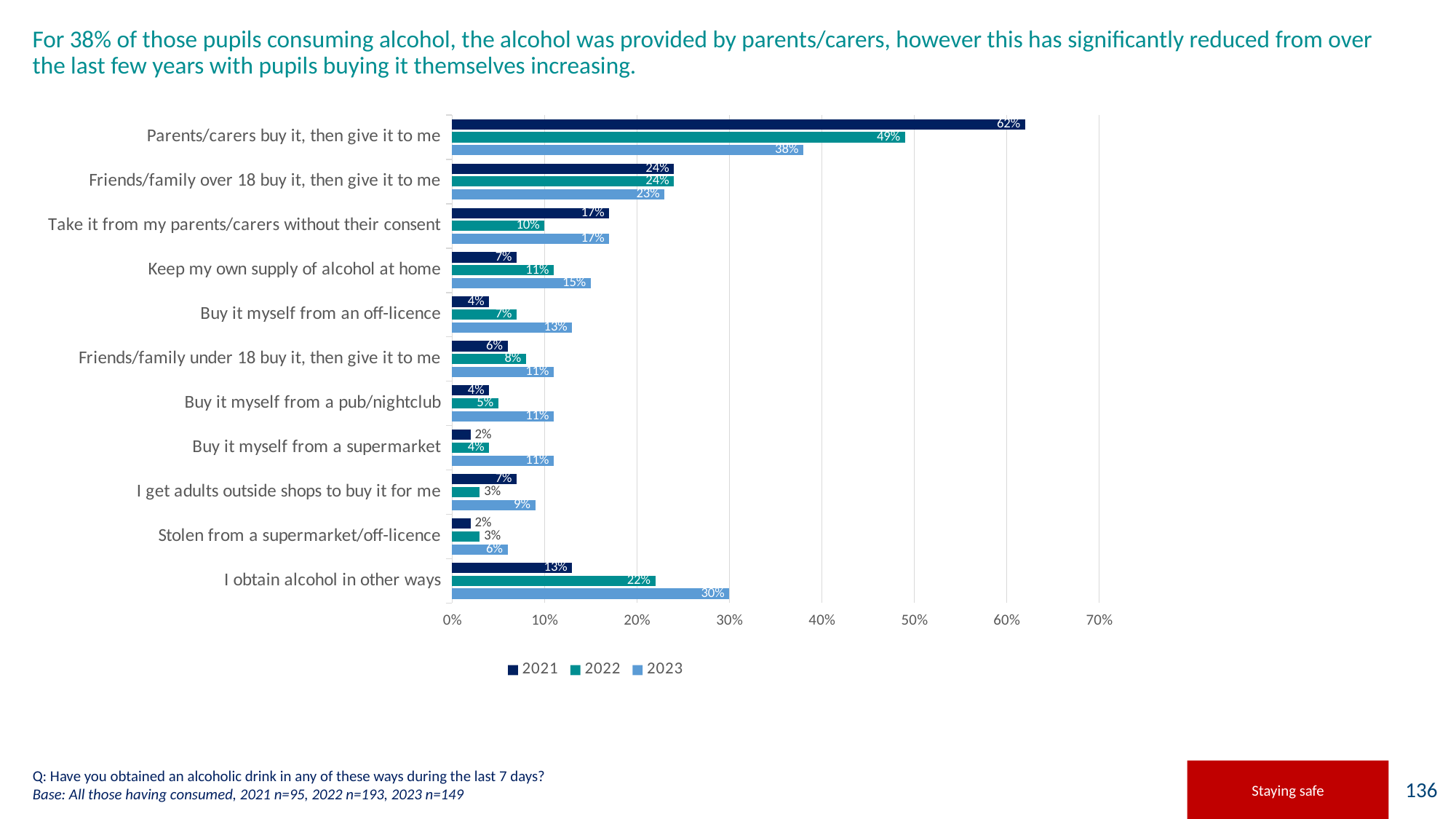
Which category has the highest 2023 value? Parents/carers buy it, then give it to me What is the 2023 value for "Parents/carers buy it, then give it to me"? 38% How many categories are shown on the chart? 11 What is the difference between the 2021 and 2023 values for "Parents/carers buy it, then give it to me"? 24 percentage points What is the 2022 value for "I obtain alcohol in other ways"? 22% Which is larger for "Buy it myself from a supermarket": the 2022 value or the 2023 value? 2023 What is the 2023 value for "Buy it myself from an off-licence"? 13% How many series does the legend list? 3 Which years are listed in the chart legend? 2021, 2022, 2023 What kind of chart is shown on the slide? Bar chart What is the 2021 value for "Parents/carers buy it, then give it to me"? 62% Which category has the lowest 2023 value? Stolen from a supermarket/off-licence